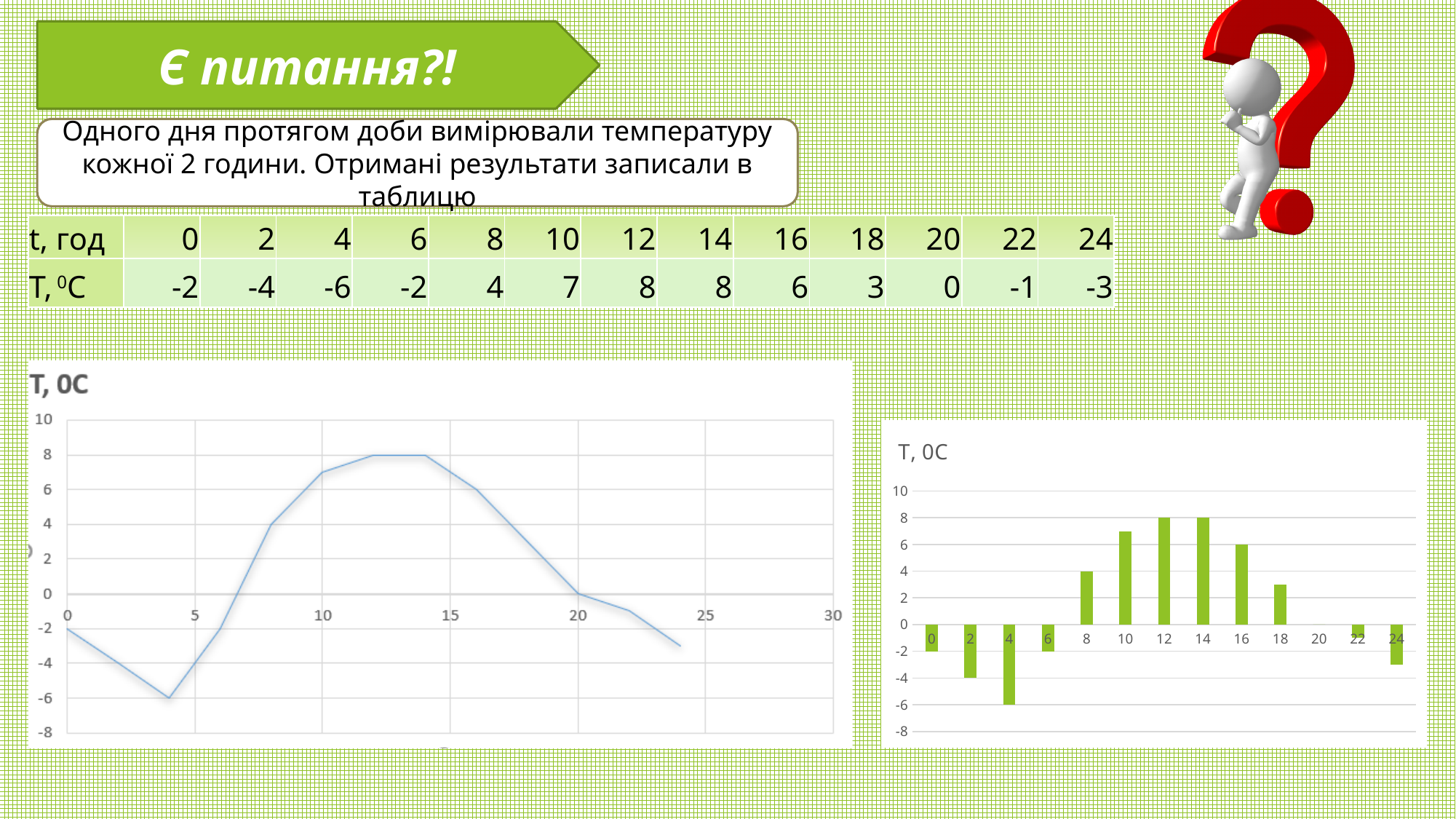
In the bar chart on the right, what is the value for hour 12? 8 In the bar chart on the right, what is the value for hour 4? -6 What kind of chart is the chart on the left of the slide? line chart In the bar chart on the right, how many bars are plotted? 12 In the bar chart on the right, which is larger, the value for hour 10 or the value for hour 18? hour 10 In the line chart on the left, does the line rise or fall between x = 4 and x = 12? rise What is the title of the bar chart on the right? T, 0C In the bar chart on the right, is the value for hour 8 greater or less than 6? less In the bar chart on the right, what is the difference between the value for hour 12 and the value for hour 4? 14 In the bar chart on the right, which hour has the lowest value? 4 What kind of chart is the chart on the right of the slide? bar chart In the bar chart on the right, what is the value for hour 16? 6